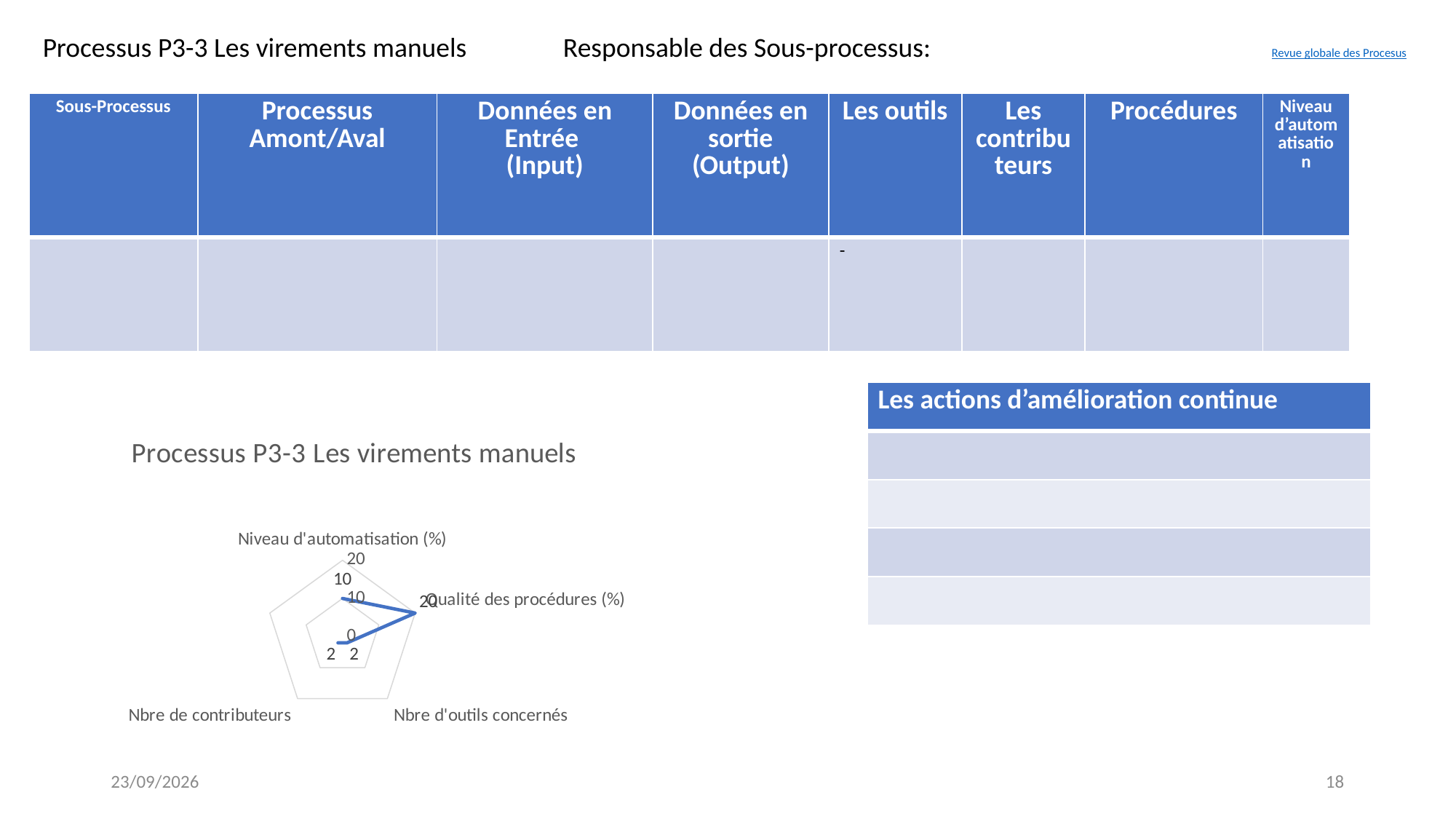
Which axis has the highest value? Qualité des procédures (%) What is the value for Qualité des procédures (%)? 20 What kind of chart is shown on the slide? Radar chart What is the title of the chart? Processus P3-3 Les virements manuels What is the difference between the value for Qualité des procédures (%) and the value for Niveau d'automatisation (%)? 10 What is the highest tick value shown on the chart's scale? 20 Which is larger, the value for Qualité des procédures (%) or the value for Niveau d'automatisation (%)? Qualité des procédures (%) Is the value for Nbre de contributeurs greater or less than 10? less Is the value for Nbre d'outils concernés greater or less than 10? less What is the value for Niveau d'automatisation (%)? 10